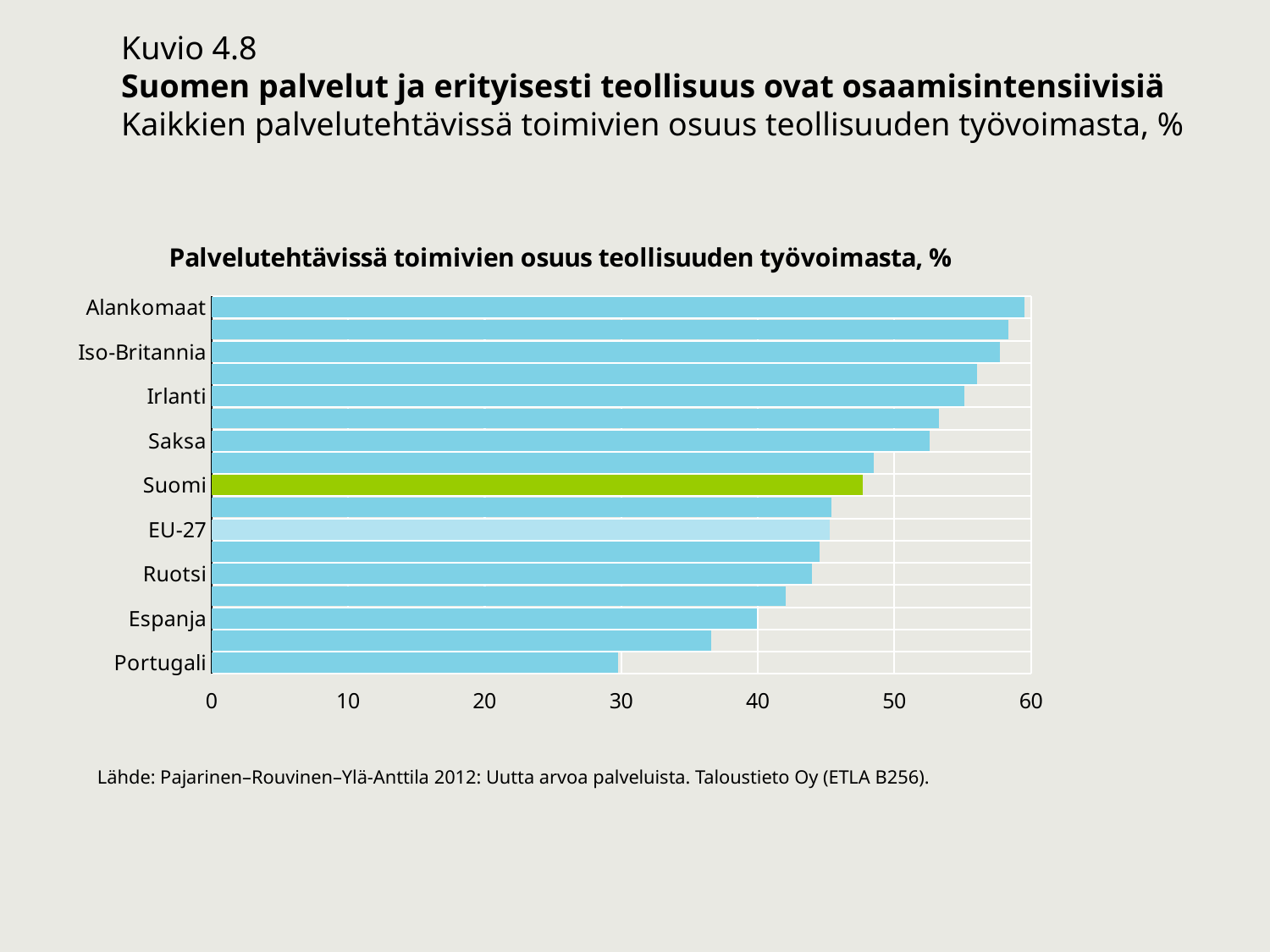
Is the value for Alankomaat greater or less than 50? greater What kind of chart is shown on the slide? bar chart Do the bar values increase or decrease going from the top of the chart to the bottom? decrease Which country has the highest share of service-task workers in industrial labour force? Alankomaat Is the value for Portugali greater or less than 40? less Which country's bar is highlighted in green? Suomi Which has a larger value, Suomi or EU-27? Suomi Is the value for Espanja greater or less than 30? greater Which country has the lowest share of service-task workers in industrial labour force? Portugali Which has a larger value, Saksa or Ruotsi? Saksa